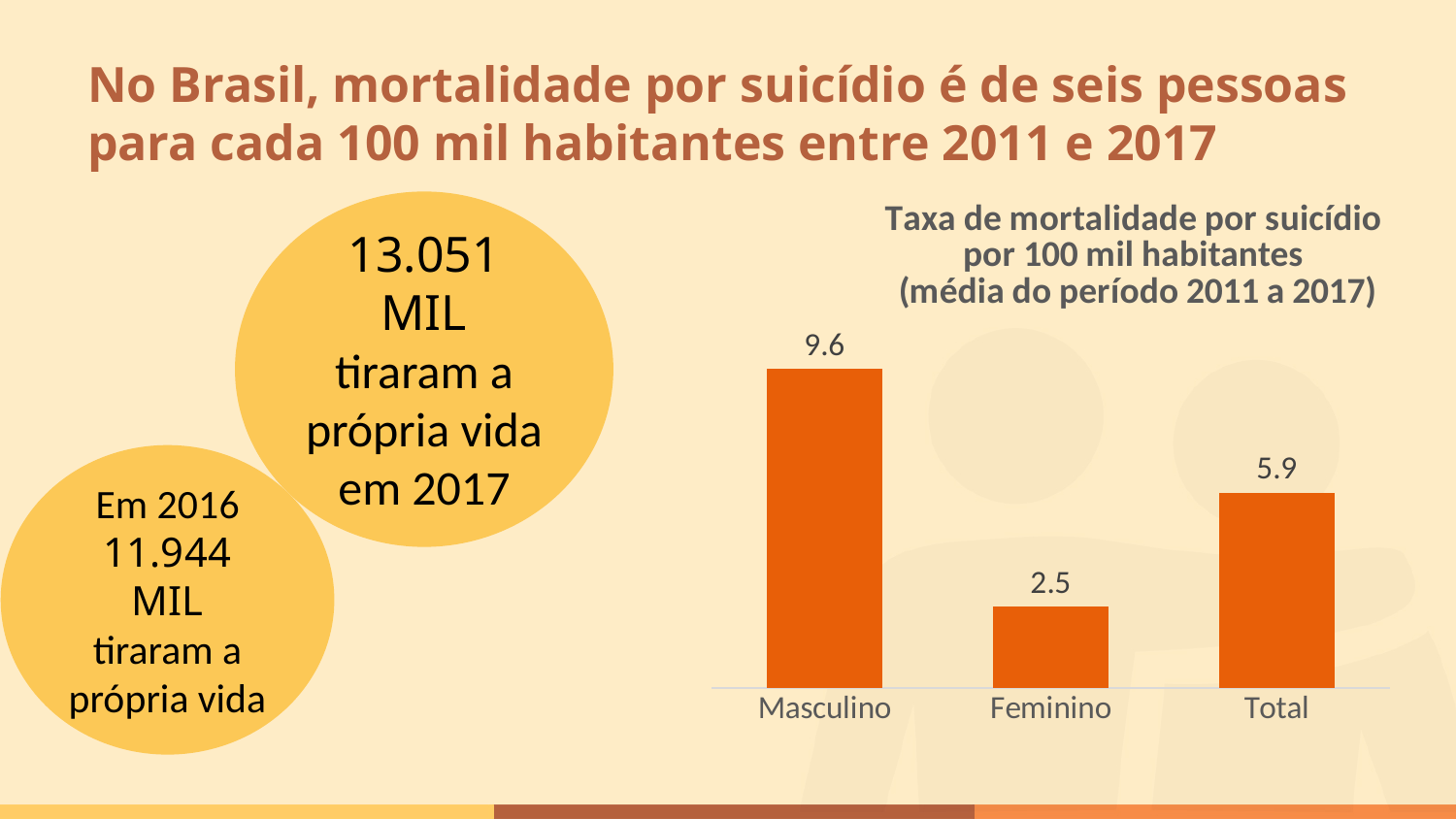
How many categories are shown in the chart? 3 What is the difference between the values for Masculino and Total? 3.7 What colour are the bars in the chart? orange Which is larger, the value for Feminino or the value for Total? Total What kind of chart is shown on the slide? bar chart What is the value for Feminino? 2.5 Which category has the lowest value? Feminino What is the difference between the values for Masculino and Feminino? 7.1 What is the value for Total? 5.9 What is the title of the chart? Taxa de mortalidade por suicídio por 100 mil habitantes (média do período 2011 a 2017) Which category has the highest value? Masculino What is the value for Masculino? 9.6